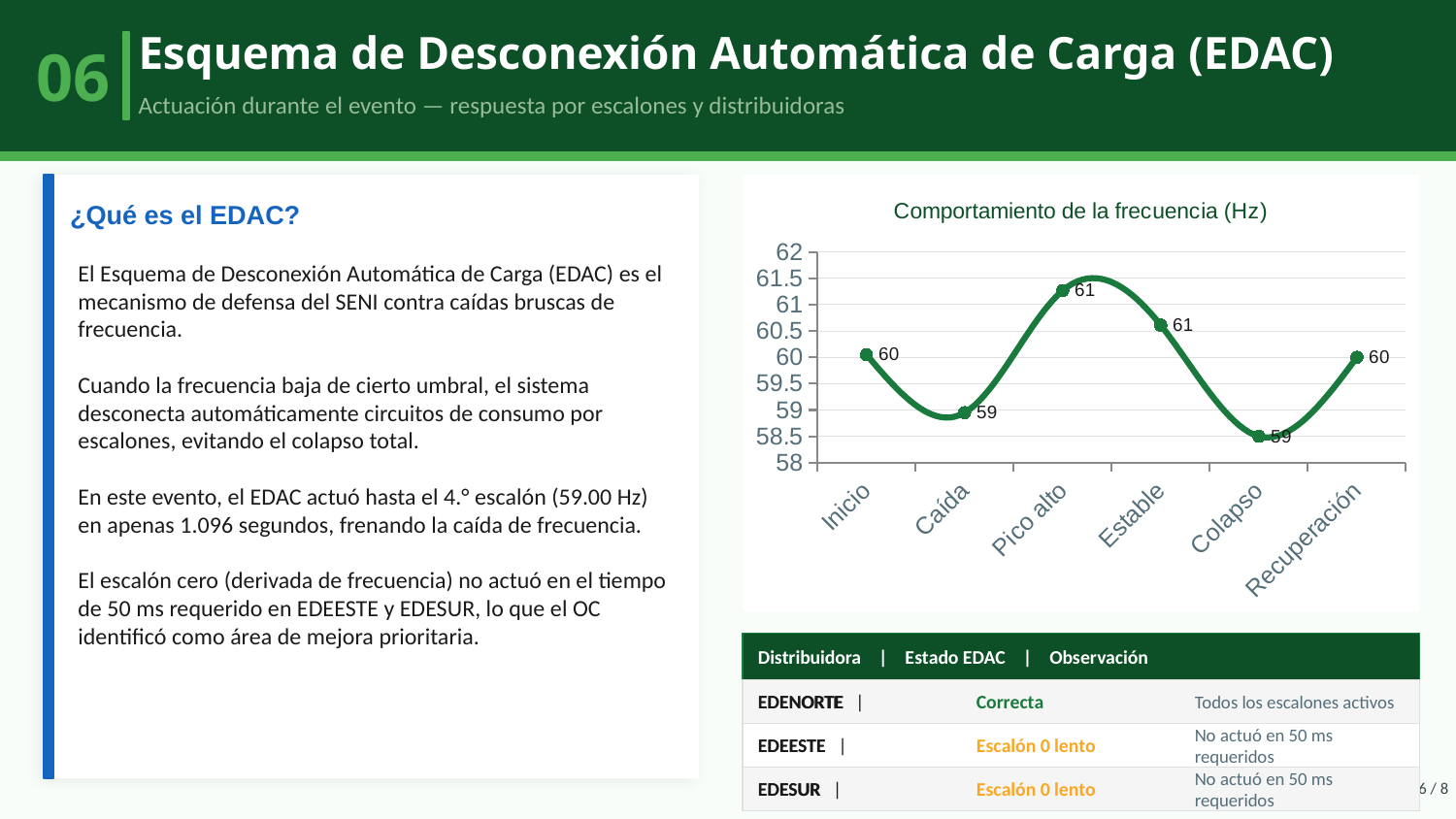
What is the value for Recuperación? 60 What is the difference between the values for Inicio and Caída? 1 What type of chart is shown on the slide? line chart What is the title of the chart on the slide? Comportamiento de la frecuencia (Hz) What is the value for Caída? 59 Is the value for Colapso greater or less than 59.5? less How many data points are plotted on the chart? 6 Which is larger, the value for Pico alto or the value for Caída? Pico alto What is the value for Inicio? 60 Is the value for Pico alto greater or less than 60.5? greater Does the value rise or fall from Inicio to Caída? fall What is the value for Pico alto? 61